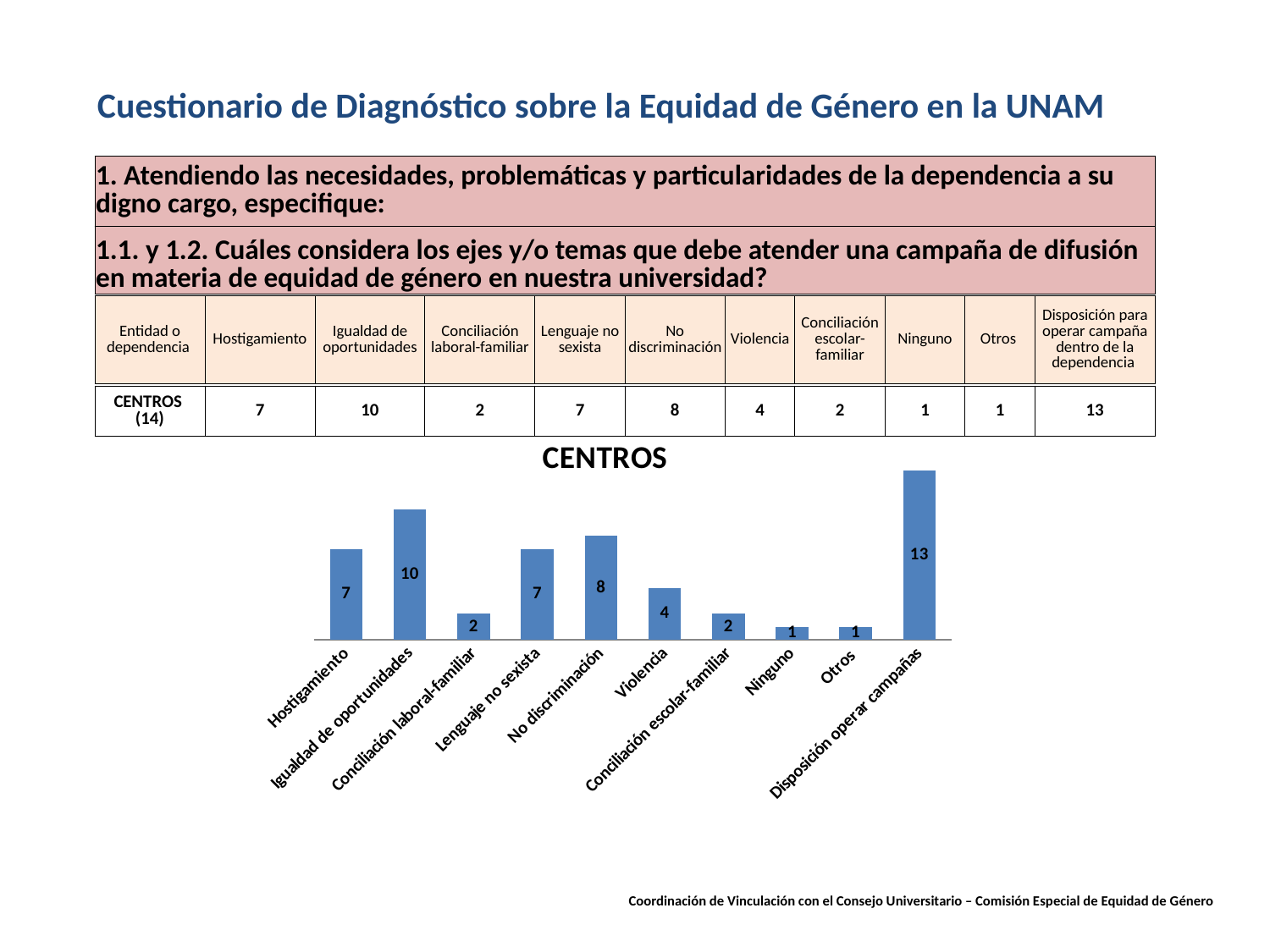
What is the difference between the values for No discriminación and Conciliación escolar-familiar in the CENTROS chart? 6 What is the difference between the values for Disposición operar campañas and Igualdad de oportunidades in the CENTROS chart? 3 Which is larger in the CENTROS chart, Hostigamiento or Violencia? Hostigamiento What is the value for Lenguaje no sexista in the CENTROS chart? 7 What is the value for Violencia in the CENTROS chart? 4 What kind of chart is the CENTROS chart? Bar chart Which two categories share the lowest value in the CENTROS chart? Ninguno and Otros How many categories are shown on the x axis of the CENTROS chart? 10 What is the value for Igualdad de oportunidades in the CENTROS chart? 10 What is the value for No discriminación in the CENTROS chart? 8 Which category has the highest value in the CENTROS chart? Disposición operar campañas What is the title of the chart on the slide? CENTROS